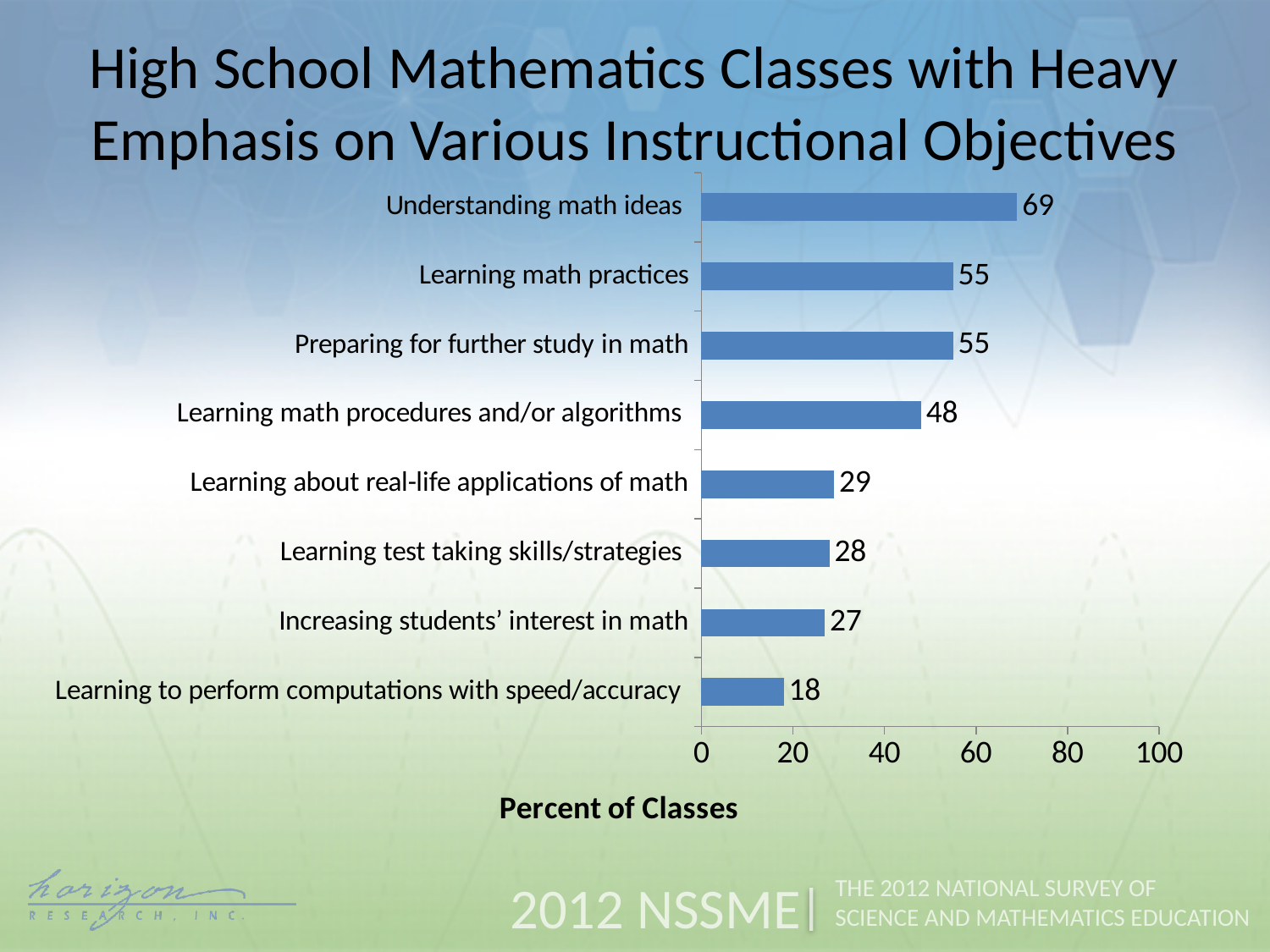
What is the label of the horizontal axis? Percent of Classes What percent of classes place heavy emphasis on understanding math ideas? 69 What is the value for learning to perform computations with speed/accuracy? 18 What is the difference between the values for learning math procedures and/or algorithms and learning test taking skills/strategies? 20 What kind of chart is shown on the slide? Bar chart What is the value for learning math procedures and/or algorithms? 48 How many instructional objectives are shown in the chart? 8 Which instructional objective has the highest percent of classes? Understanding math ideas Which instructional objective has the lowest percent of classes? Learning to perform computations with speed/accuracy What is the difference between the values for understanding math ideas and learning math practices? 14 Which is larger: the value for learning about real-life applications of math or the value for increasing students' interest in math? Learning about real-life applications of math Is the value for preparing for further study in math greater or less than 40? greater